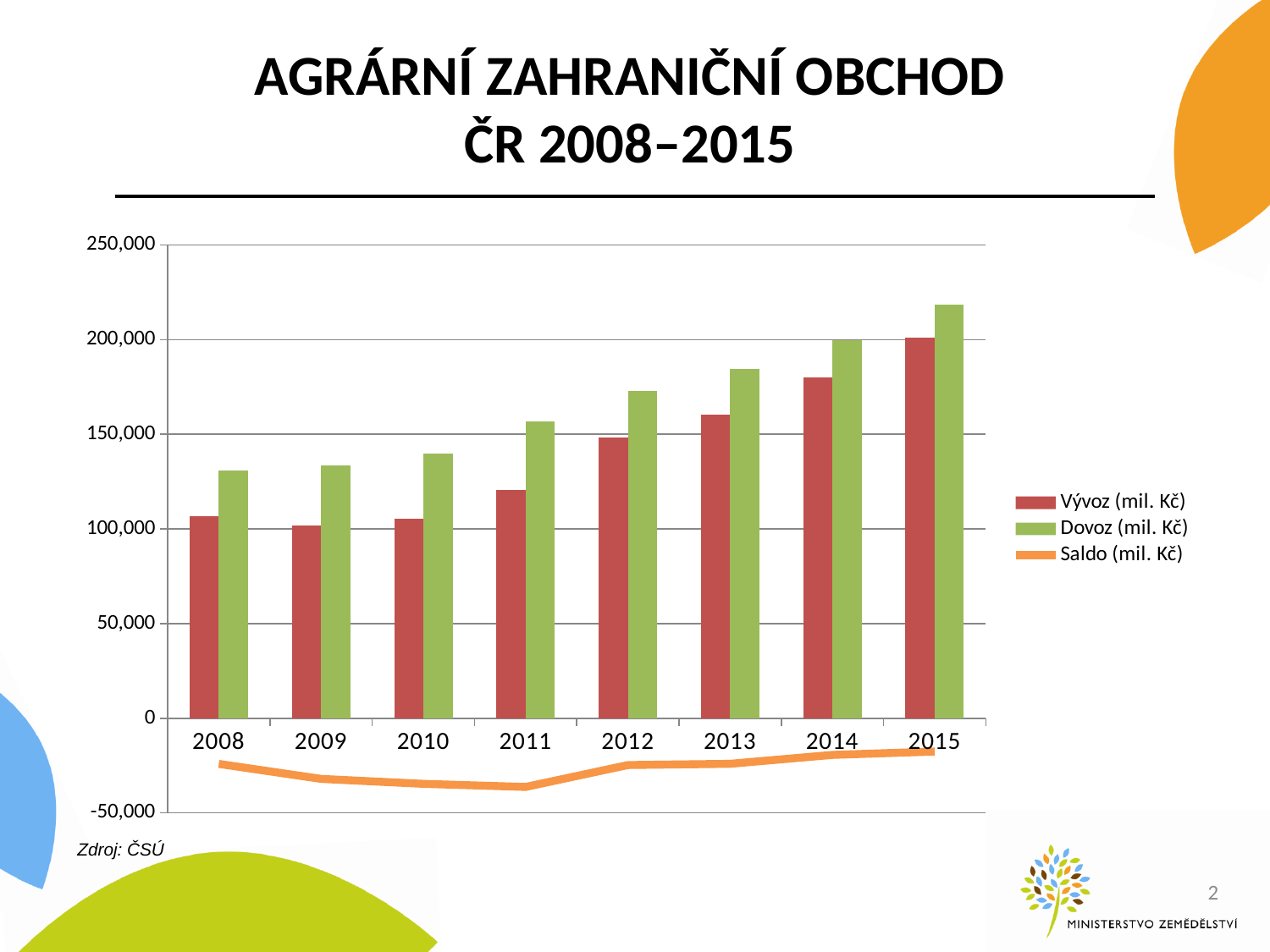
How many years are shown on the x axis? 8 Which year has the lowest value for Saldo (mil. Kč)? 2011 Is the value for Dovoz (mil. Kč) in 2015 greater or less than 200,000? greater What kind of chart is shown on the slide? A bar chart with a line series What source is cited below the chart? ČSÚ Is the value for Vývoz (mil. Kč) in 2014 greater or less than 150,000? greater In 2012, which is larger: Vývoz (mil. Kč) or Dovoz (mil. Kč)? Dovoz (mil. Kč) Does the Vývoz (mil. Kč) series generally rise or fall from 2010 to 2015? rise How many series does the legend list? 3 Which year has the highest value for Dovoz (mil. Kč)? 2015 Is the value for Dovoz (mil. Kč) in 2013 greater or less than 200,000? less Which year has the highest value for Vývoz (mil. Kč)? 2015